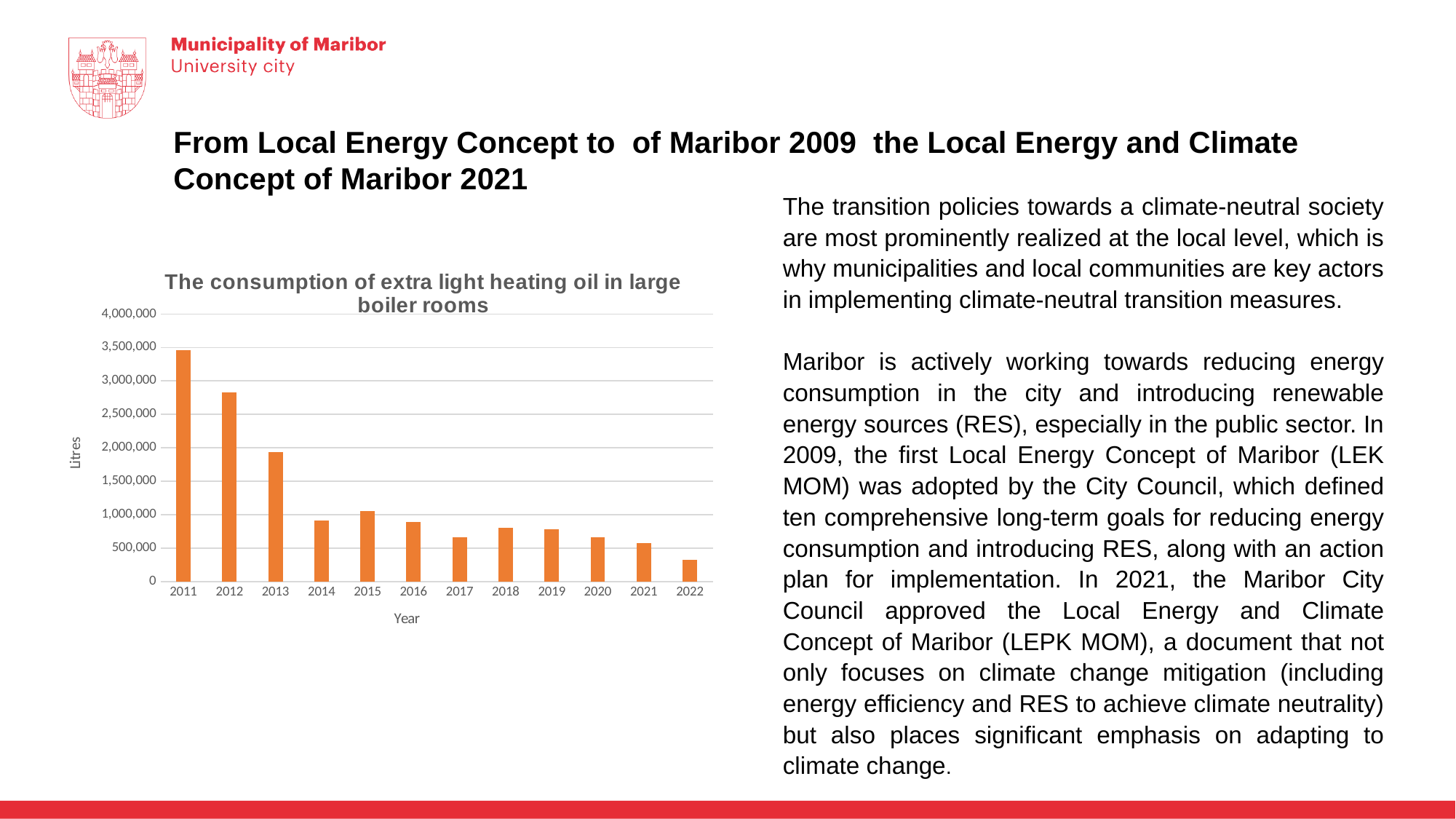
Is the value for 2022 greater or less than 500,000? less What is the label on the vertical axis of the chart? Litres How many years are plotted on the chart? 12 What kind of chart is shown on the slide? Bar chart Which year has the highest consumption of extra light heating oil in large boiler rooms? 2011 Which year has the larger value, 2014 or 2015? 2015 Which year has the larger value, 2012 or 2013? 2012 Which year has the lowest consumption of extra light heating oil in large boiler rooms? 2022 Overall, do the values rise or fall from 2011 to 2022? Fall Is the value for 2013 greater or less than 2,000,000? less Is the value for 2014 greater or less than 1,000,000? less